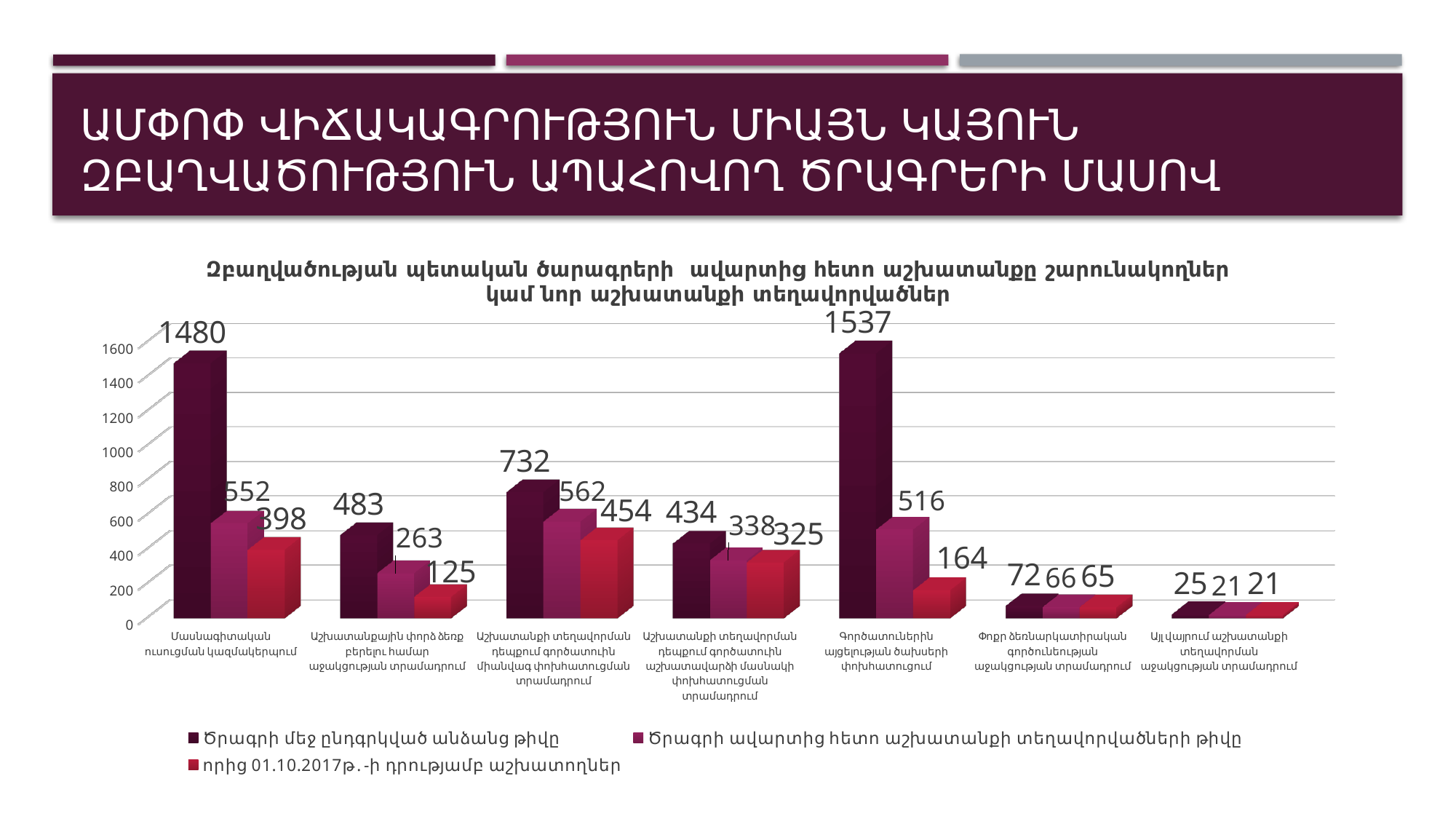
How many series does the legend list? 3 What is the difference between 'Ծրագրի ավարտից հետո աշխատանքի տեղավորվածների թիվը' and 'որից 01.10.2017թ.-ի դրությամբ աշխատողներ' for 'Մասնագիտական ուսուցման կազմակերպում'? 154 What is the value of 'Ծրագրի ավարտից հետո աշխատանքի տեղավորվածների թիվը' for 'Փոքր ձեռնարկատիրական գործունեության աջակցության տրամադրում'? 66 What is the value of 'Ծրագրի մեջ ընդգրկված անձանց թիվը' for 'Մասնագիտական ուսուցման կազմակերպում'? 1480 What is the value of 'Ծրագրի ավարտից հետո աշխատանքի տեղավորվածների թիվը' for 'Գործատուներին այցելության ծախսերի փոխհատուցում'? 516 Which category has the lowest value for 'Ծրագրի ավարտից հետո աշխատանքի տեղավորվածների թիվը'? Այլ վայրում աշխատանքի տեղավորման աջակցության տրամադրում What is the value of 'որից 01.10.2017թ.-ի դրությամբ աշխատողներ' for 'Աշխատանքային փորձ ձեռք բերելու համար աջակցության տրամադրում'? 125 What type of chart is shown on the slide? Bar chart Which is larger: 'Ծրագրի մեջ ընդգրկված անձանց թիվը' for 'Աշխատանքի տեղավորման դեպքում գործատուին միանվագ փոխհատուցման տրամադրում' or for 'Աշխատանքային փորձ ձեռք բերելու համար աջակցության տրամադրում'? Աշխատանքի տեղավորման դեպքում գործատուին միանվագ փոխհատուցման տրամադրում Which category has the highest value for 'Ծրագրի մեջ ընդգրկված անձանց թիվը'? Գործատուներին այցելության ծախսերի փոխհատուցում What is the difference between 'Ծրագրի մեջ ընդգրկված անձանց թիվը' and 'Ծրագրի ավարտից հետո աշխատանքի տեղավորվածների թիվը' for 'Գործատուներին այցելության ծախսերի փոխհատուցում'? 1021 How many categories are shown on the x axis? 7